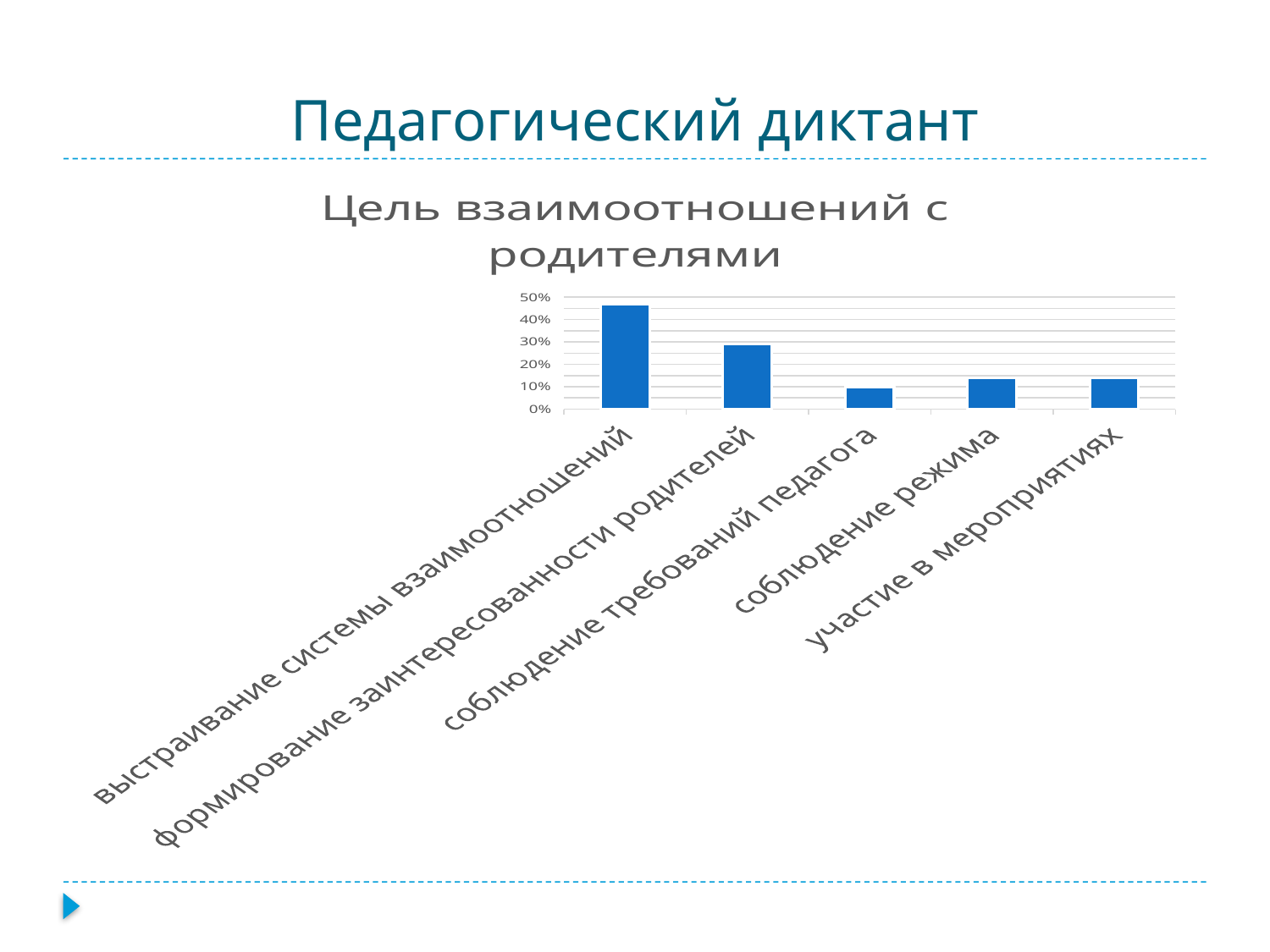
Which is larger: the value for соблюдение режима or the value for соблюдение требований педагога? соблюдение режима What kind of chart is shown on the slide? bar chart Which category has the highest value? выстраивание системы взаимоотношений Which is larger: the value for выстраивание системы взаимоотношений or the value for формирование заинтересованности родителей? выстраивание системы взаимоотношений Is the value for участие в мероприятиях greater or less than 20%? less Is the value for соблюдение требований педагога greater or less than 20%? less Is the value for формирование заинтересованности родителей greater or less than 20%? greater How many categories are shown in the chart? 5 What is the title of the chart? Цель взаимоотношений с родителями Which category has the lowest value? соблюдение требований педагога